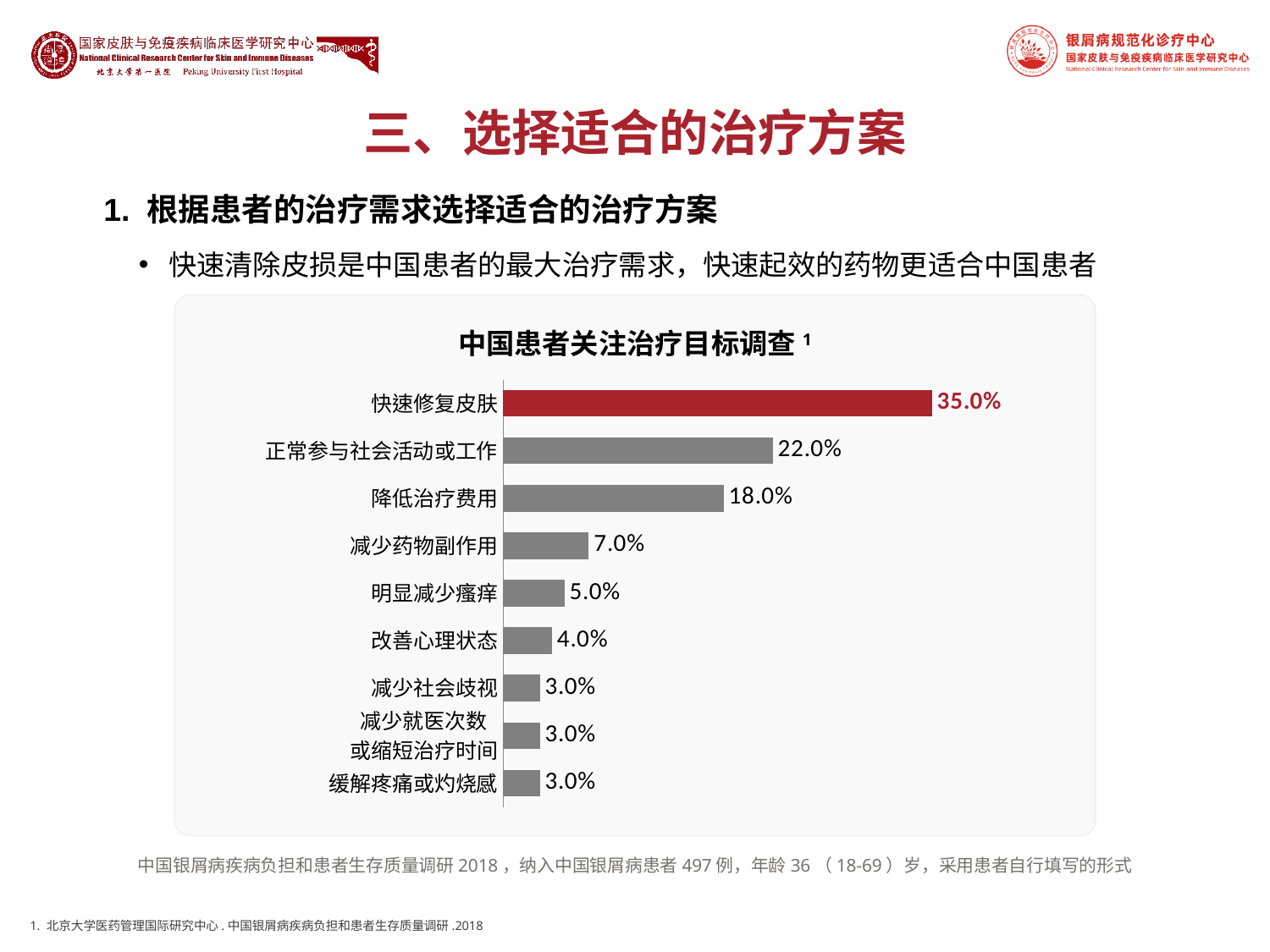
What is the value for 快速修复皮肤? 35.0% Which is larger, the value for 减少药物副作用 or the value for 改善心理状态? 减少药物副作用 What is the value for 降低治疗费用? 18.0% What is the difference between the values for 降低治疗费用 and 减少药物副作用? 11.0% What is the title of the chart? 中国患者关注治疗目标调查 What kind of chart is shown on the slide? bar chart What is the difference between the values for 快速修复皮肤 and 正常参与社会活动或工作? 13.0% Which category has the highest value? 快速修复皮肤 What is the value for 正常参与社会活动或工作? 22.0% What is the value for 明显减少瘙痒? 5.0% Which bar is coloured red rather than grey? 快速修复皮肤 How many categories are shown in the chart? 9